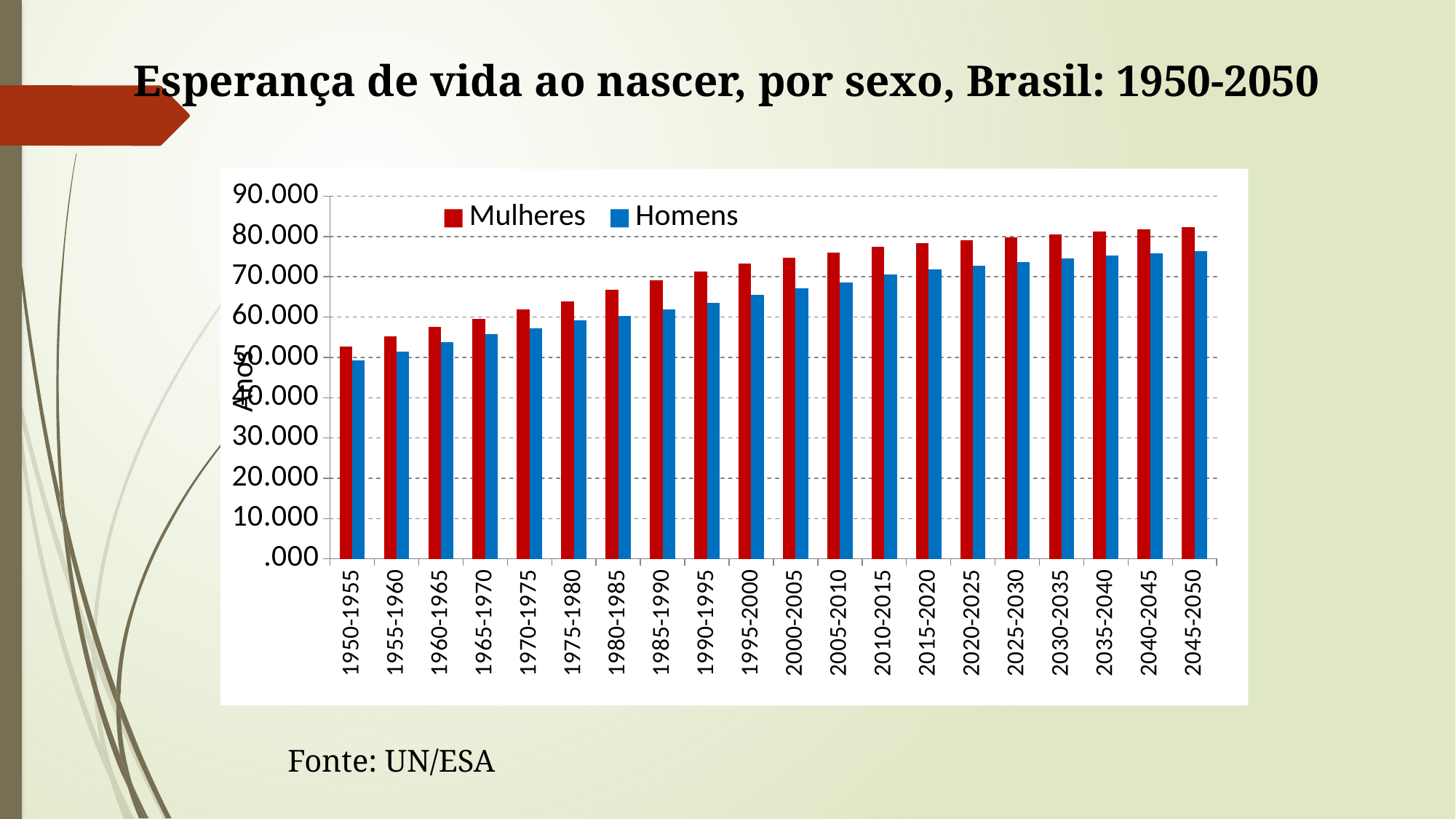
How many time periods are shown on the x axis? 20 Is the value for Homens in 2045-2050 greater or less than 80.000? less Is the value for Mulheres in 2045-2050 greater or less than 80.000? greater In which period is the value for Homens lowest? 1950-1955 Which series is shown in red in the legend? Mulheres How many series does the legend list? 2 Do the values for Mulheres rise or fall from 1950-1955 to 2045-2050? rise What kind of chart is shown on the slide? bar chart In 1950-1955, which is larger, the value for Mulheres or the value for Homens? Mulheres In which period is the value for Mulheres highest? 2045-2050 Is the value for Mulheres in 2000-2005 greater or less than 70.000? greater